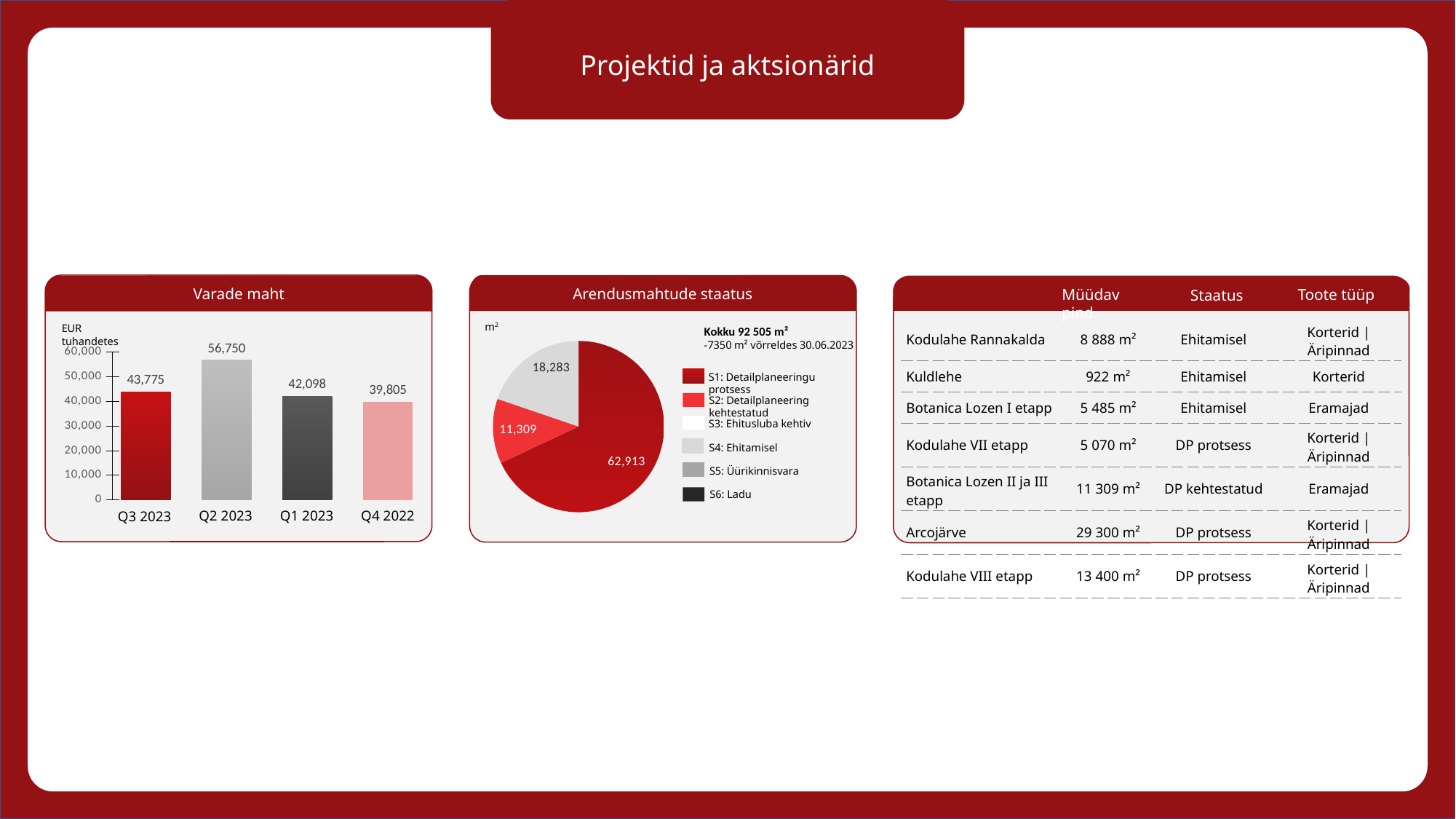
How many entries does the legend of the 'Arendusmahtude staatus' chart list? 6 In the 'Varade maht' chart, what is the value for Q4 2022? 39,805 In the 'Arendusmahtude staatus' chart, what is the value of the S2: Detailplaneering kehtestatud slice? 11,309 In the 'Varade maht' chart, which quarter has the highest value? Q2 2023 In the 'Varade maht' chart, which is larger, Q3 2023 or Q1 2023? Q3 2023 In the 'Arendusmahtude staatus' chart, which slice is the largest? S1: Detailplaneeringu protsess What type of chart is 'Arendusmahtude staatus'? pie chart In the 'Varade maht' chart, what is the difference between Q2 2023 and Q3 2023? 12,975 In the 'Varade maht' chart, what is the value for Q2 2023? 56,750 In the 'Varade maht' chart, which quarter has the lowest value? Q4 2022 What type of chart is 'Varade maht'? bar chart How many quarters are shown in the 'Varade maht' chart? 4